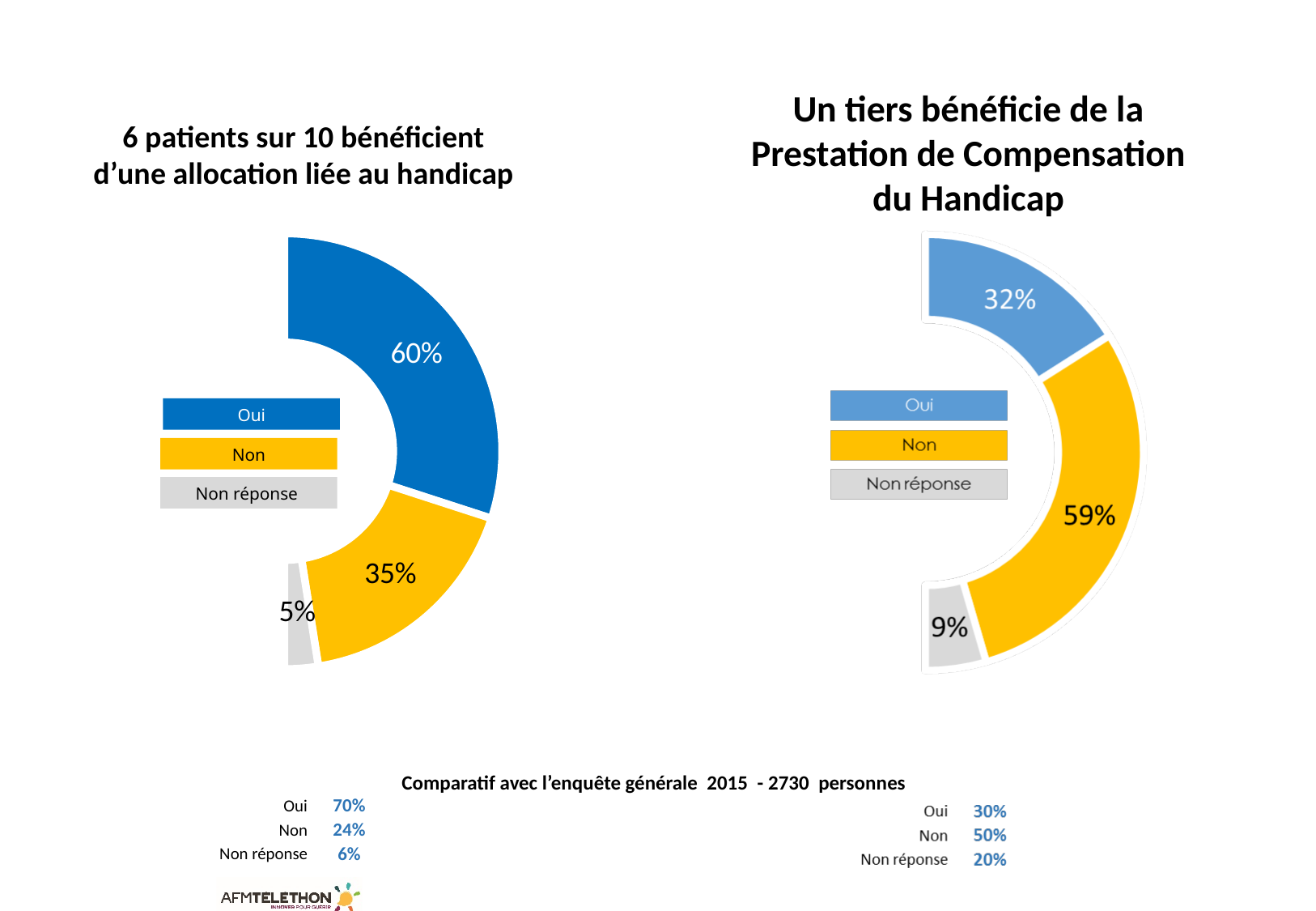
How many categories does the legend of the left chart titled "6 patients sur 10 bénéficient d'une allocation liée au handicap" list? 3 In the right chart titled "Un tiers bénéficie de la Prestation de Compensation du Handicap", which is larger, "Oui" or "Non"? Non In the right chart titled "Un tiers bénéficie de la Prestation de Compensation du Handicap", what percentage is shown for "Oui"? 32% In the right chart titled "Un tiers bénéficie de la Prestation de Compensation du Handicap", what percentage is shown for "Non réponse"? 9% In the right chart titled "Un tiers bénéficie de la Prestation de Compensation du Handicap", what percentage is shown for "Non"? 59% In the left chart titled "6 patients sur 10 bénéficient d'une allocation liée au handicap", what percentage is shown for "Non réponse"? 5% In the left chart titled "6 patients sur 10 bénéficient d'une allocation liée au handicap", what percentage is shown for "Non"? 35% In the left chart titled "6 patients sur 10 bénéficient d'une allocation liée au handicap", what is the difference in percentage points between "Oui" and "Non"? 25 In the left chart titled "6 patients sur 10 bénéficient d'une allocation liée au handicap", which category has the largest share? Oui In the right chart titled "Un tiers bénéficie de la Prestation de Compensation du Handicap", which category has the smallest share? Non réponse In the left chart titled "6 patients sur 10 bénéficient d'une allocation liée au handicap", what percentage is shown for "Oui"? 60% What kind of chart is the right chart titled "Un tiers bénéficie de la Prestation de Compensation du Handicap"? Pie (doughnut) chart